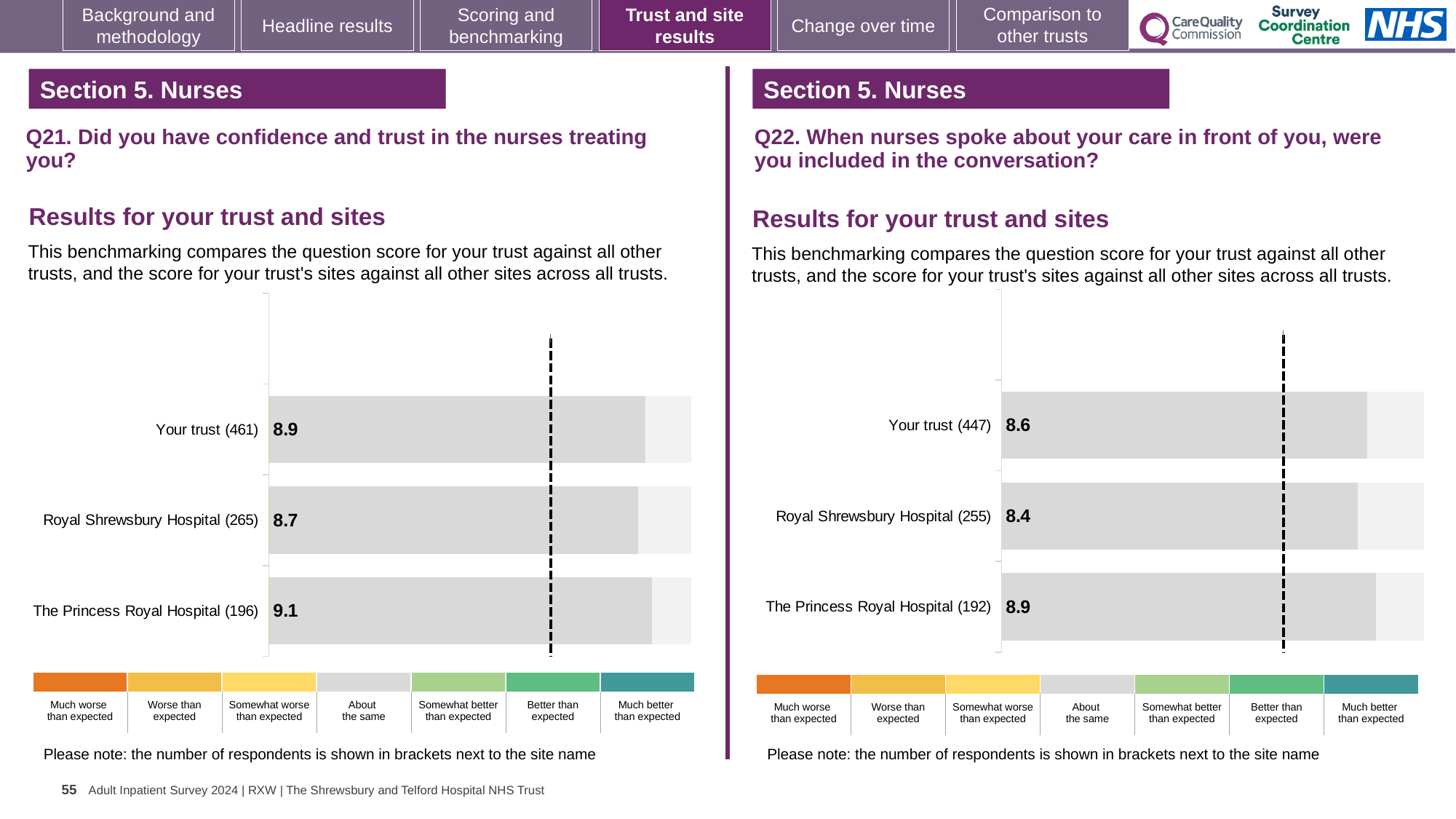
On the Q22 chart (right), which is larger: the score for Your trust (447) or Royal Shrewsbury Hospital (255)? Your trust (447) On the Q21 chart (left), what is the difference between the scores for The Princess Royal Hospital (196) and Royal Shrewsbury Hospital (265)? 0.4 On the Q22 chart (right), which site or trust has the lowest score? Royal Shrewsbury Hospital (255) On the Q21 chart (left), what is the score for Your trust (461)? 8.9 On the Q22 chart (right), what is the score for Your trust (447)? 8.6 On the Q21 chart (left), what is the score for Royal Shrewsbury Hospital (265)? 8.7 What kind of chart is used on the Q22 chart (right)? Bar chart On the Q21 chart (left), which site or trust has the highest score? The Princess Royal Hospital (196) On the Q22 chart (right), what is the difference between the scores for The Princess Royal Hospital (192) and Your trust (447)? 0.3 How many bars are plotted on the Q21 chart (left)? 3 On the Q21 chart (left), which site or trust has the lowest score? Royal Shrewsbury Hospital (265) On the Q22 chart (right), what is the score for The Princess Royal Hospital (192)? 8.9